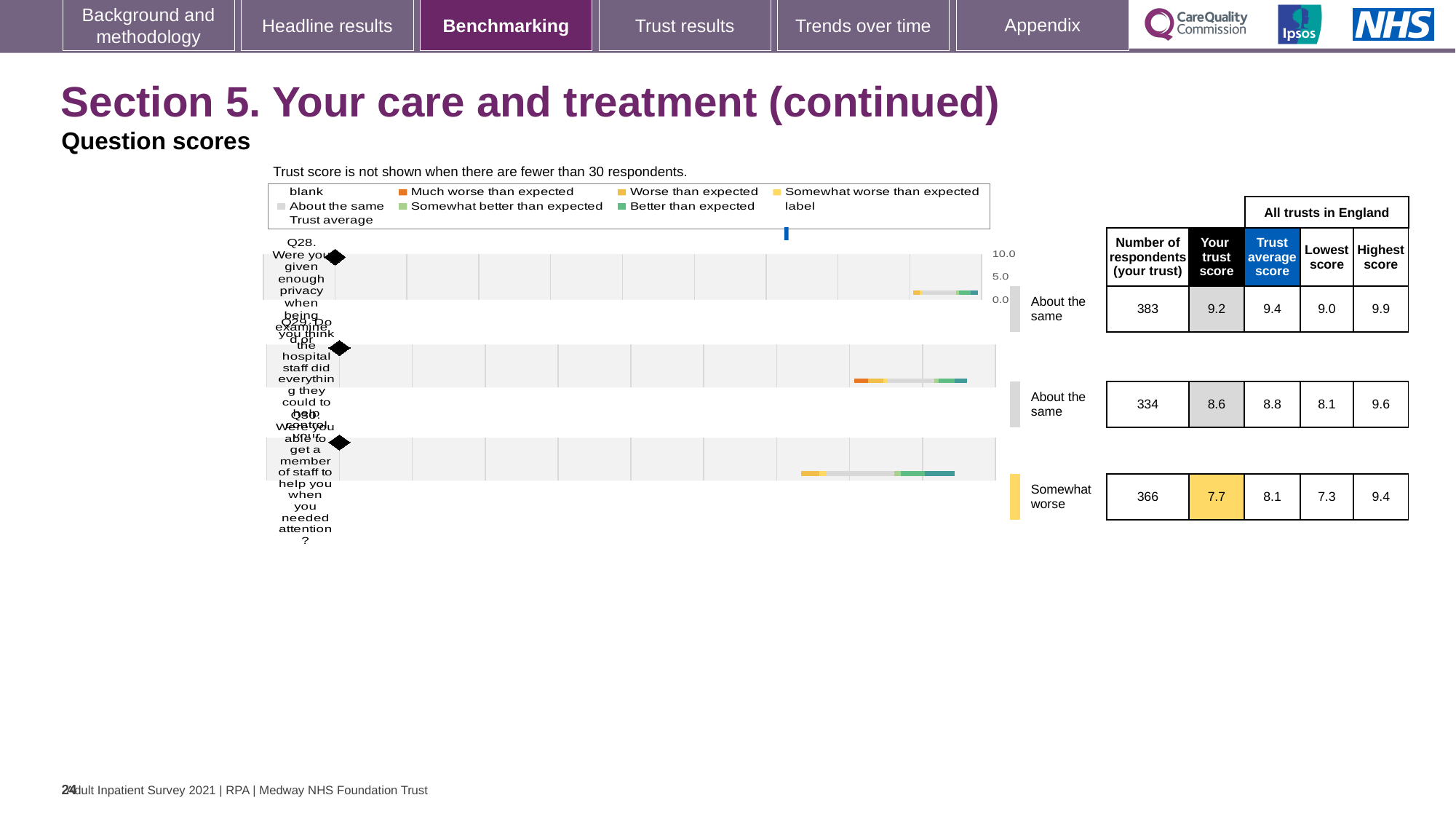
What benchmark category is shown for Q30? Somewhat worse What is the highest score across all trusts in England for Q30? 9.4 How many questions are plotted on this slide? 3 How many respondents from your trust answered Q28? 383 Which question has the lowest 'Your trust score' on this slide? Q30 What is the 'Your trust score' for Q28 (Were you given enough privacy when being examined or treated?)? 9.2 What is the difference between the highest and lowest scores across all trusts in England for Q30? 2.1 What is the 'Your trust score' for Q30 (Were you able to get a member of staff to help you when you needed attention?)? 7.7 Which has the higher 'Your trust score', Q29 or Q30? Q29 What is the lowest score across all trusts in England for Q29? 8.1 What is the trust average score for Q29 (Do you think the hospital staff did everything they could to help control your pain?)? 8.8 What is the difference between the trust average score and your trust score for Q28? 0.2